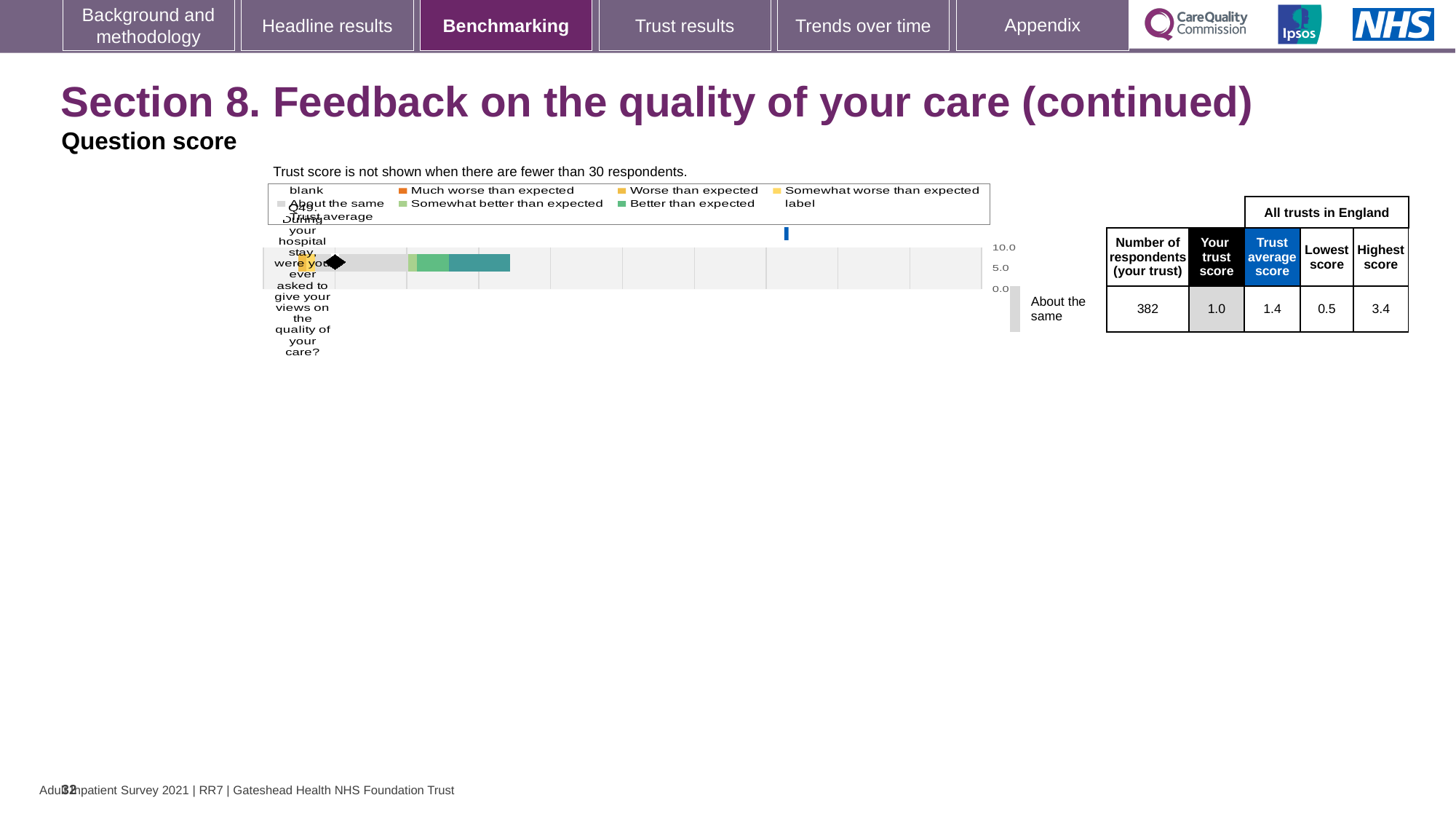
How many respondents from the trust answered Q49? 382 What is the highest score across all trusts in England for Q49? 3.4 What is the trust score for Q49 shown in the table next to the chart? 1.0 What is the lowest score across all trusts in England for Q49? 0.5 What is the difference between the trust average score and the trust score for Q49? 0.4 What is the highest value shown on the chart's axis? 10.0 What kind of chart is used to show the Q49 benchmarking result? Bar chart What benchmark category is the trust's Q49 result labelled as on the chart? About the same What is the trust average score for Q49 shown in the table? 1.4 Which legend entry is shown in orange on the chart? Much worse than expected Which is larger for Q49, the trust score or the trust average score? Trust average score What is the difference between the highest score and the lowest score for Q49? 2.9